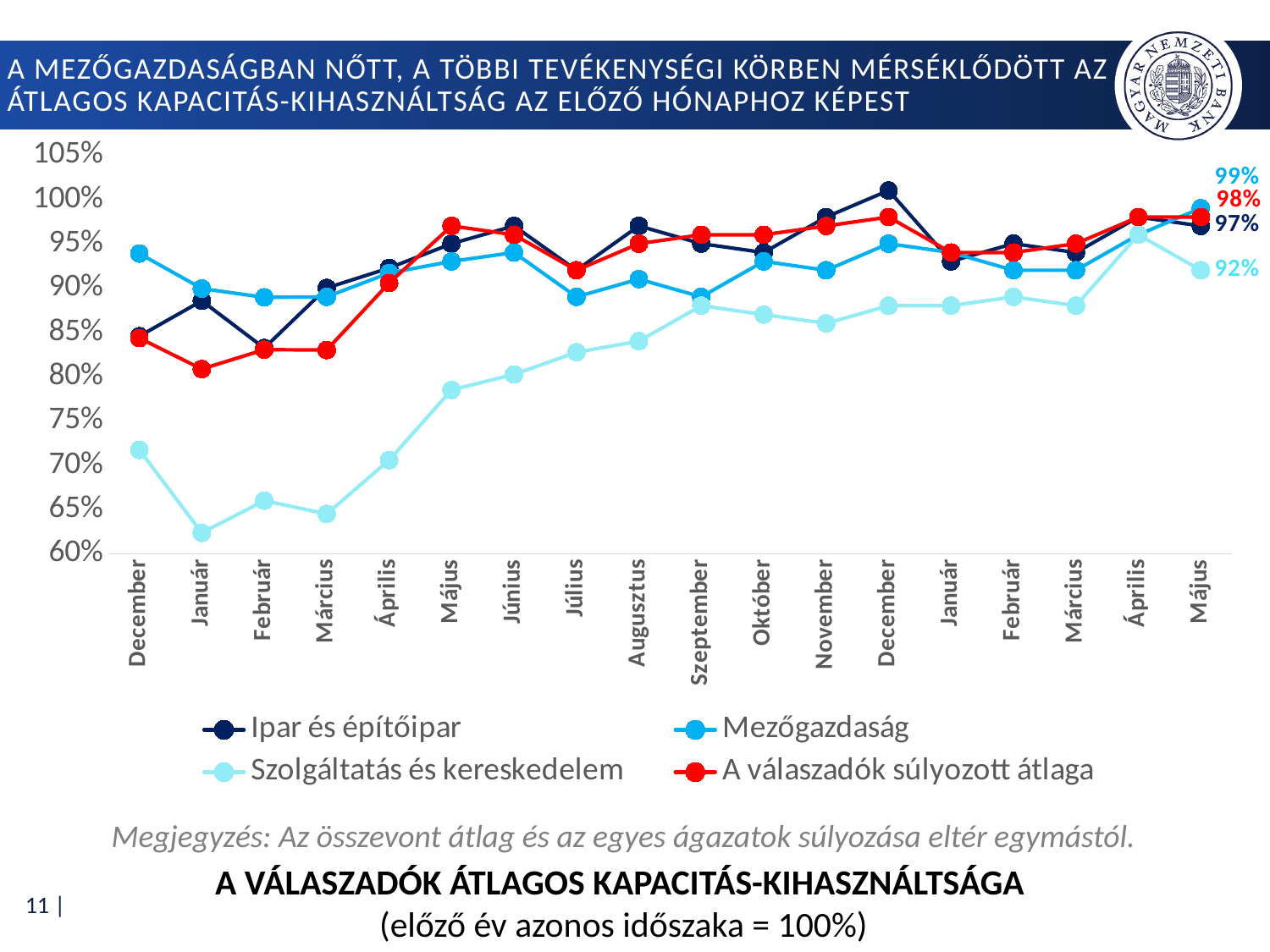
What kind of chart is shown on the slide? line chart What is the difference between the final Május values of Mezőgazdaság and Szolgáltatás és kereskedelem? 7 percentage points What is the value for Ipar és építőipar in the final Május? 97% How many series does the legend list? 4 Does the Szolgáltatás és kereskedelem series rise or fall overall from the first December to the final Május? rise What is the value for Mezőgazdaság in the final Május? 99% What is the value for A válaszadók súlyozott átlaga in the final Május? 98% How many months are shown along the x axis? 18 Which series has the highest value in the final Május? Mezőgazdaság What is the value for Szolgáltatás és kereskedelem in the final Május? 92% Which series has the lowest value in the final Május? Szolgáltatás és kereskedelem Is the value for Szolgáltatás és kereskedelem in the first Január greater or less than 65%? less